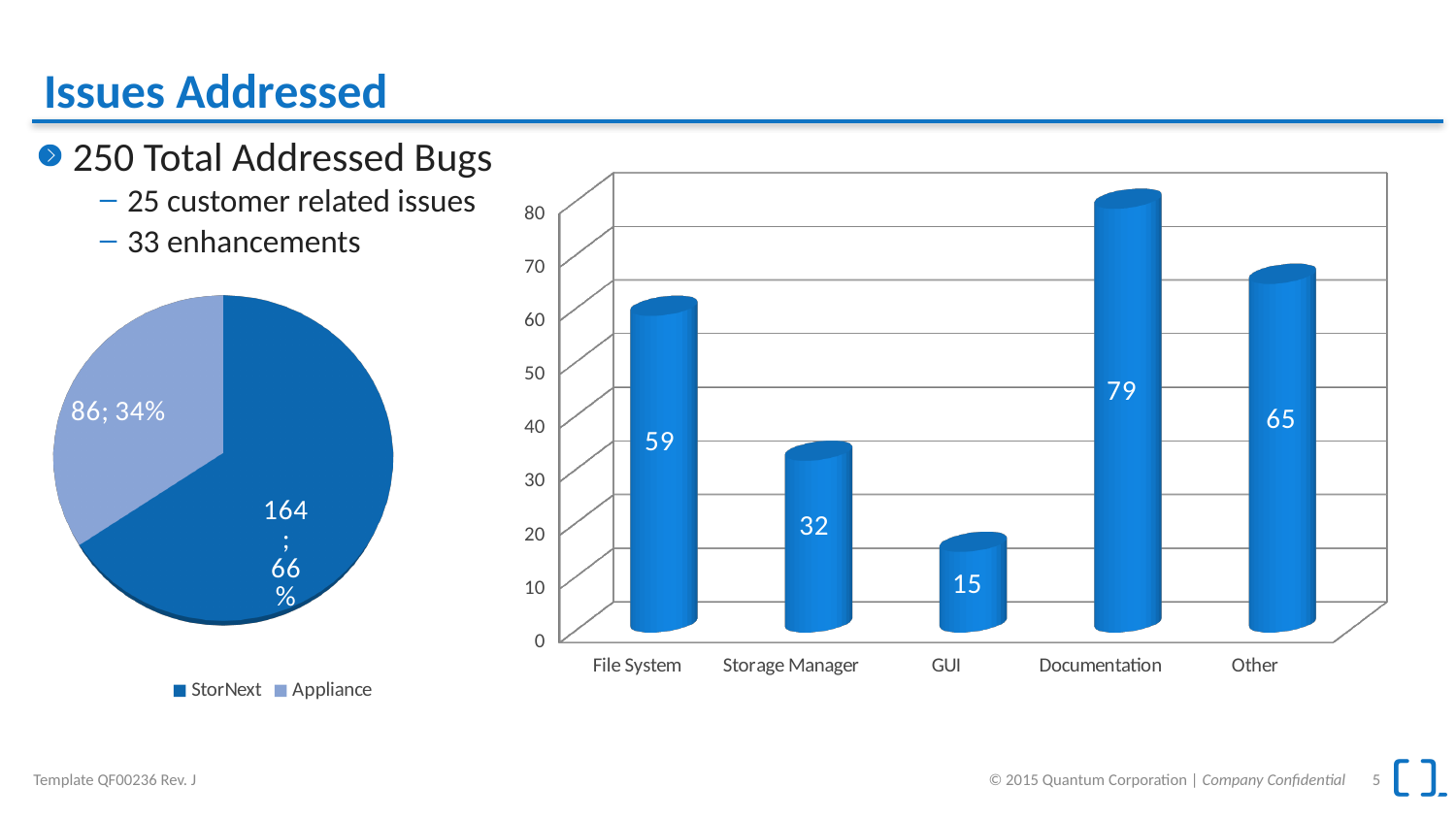
What kind of chart is the chart on the right of the slide? Bar chart In the bar chart on the right, what is the value for Storage Manager? 32 In the bar chart on the right, how many categories are shown on the x axis? 5 In the pie chart on the left, what share of the pie does the Appliance slice represent? 34% In the bar chart on the right, which is larger, the value for File System or the value for Other? Other In the bar chart on the right, which category has the highest value? Documentation In the pie chart on the left, which slice is larger, StorNext or Appliance? StorNext In the bar chart on the right, what is the value for Documentation? 79 In the pie chart on the left, what value is shown for the StorNext slice? 164 In the pie chart on the left, how many entries does the legend list? 2 In the bar chart on the right, what is the difference between the values for Documentation and File System? 20 In the bar chart on the right, which category has the lowest value? GUI